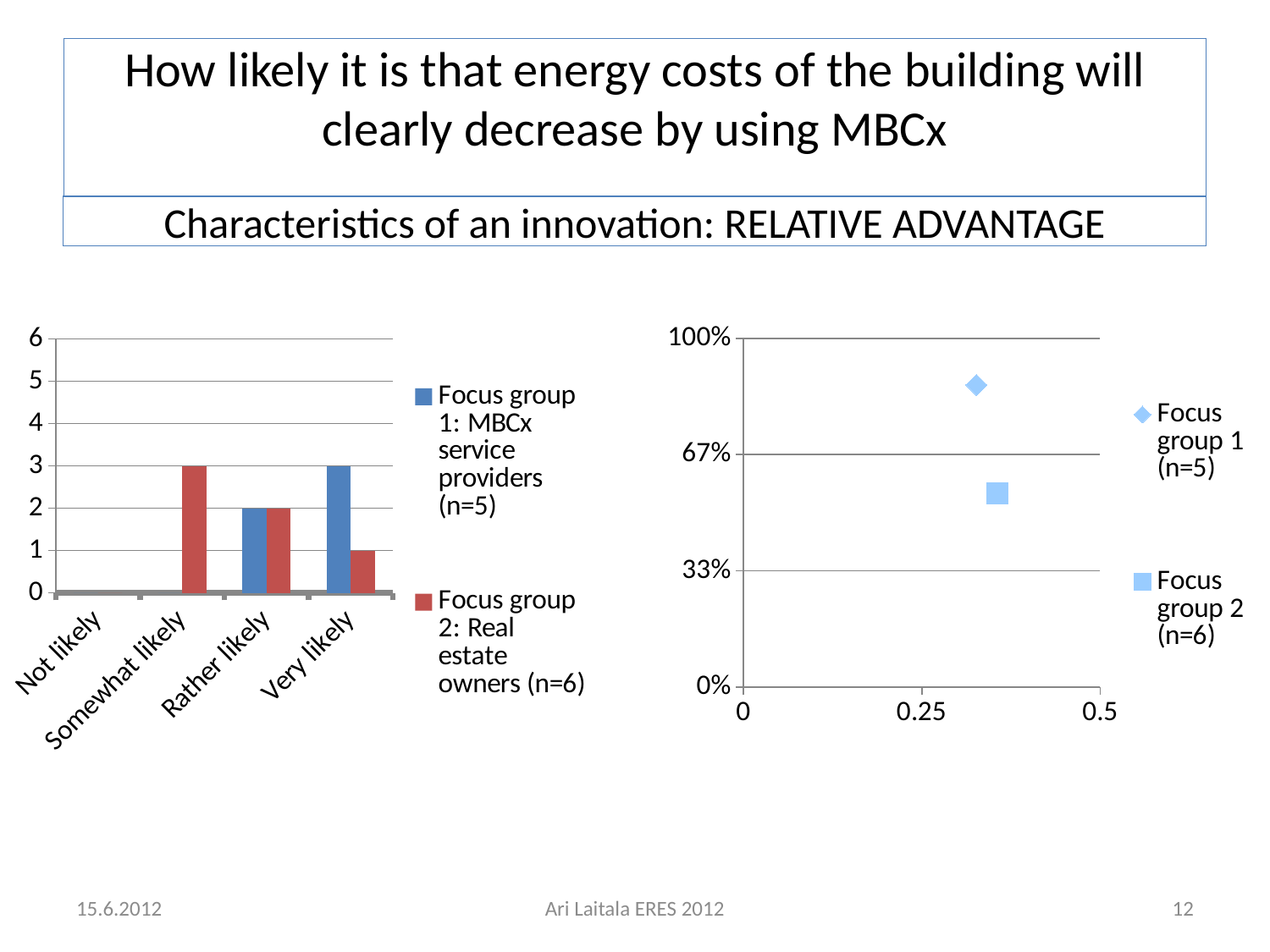
How many categories are shown on the x axis of the left bar chart? 4 In the left bar chart, what is the difference between Focus group 1 and Focus group 2 for Very likely? 2 In the left bar chart, which category has the highest value for Focus group 2: Real estate owners (n=6)? Somewhat likely In the left bar chart, which is larger for Very likely: Focus group 1 or Focus group 2? Focus group 1 In the right scatter chart, is the vertical value for Focus group 2 (n=6) greater or less than 67%? less In the left bar chart, what is the value for Focus group 1: MBCx service providers (n=5) for Very likely? 3 What kind of chart is the chart on the left of the slide? Bar chart In the left bar chart, what is the value for Focus group 1: MBCx service providers (n=5) for Rather likely? 2 In the left bar chart, what is the value for Focus group 2: Real estate owners (n=6) for Somewhat likely? 3 In the right scatter chart, is the vertical value for Focus group 1 (n=5) greater or less than 67%? greater How many series does the legend of the left chart list? 2 In the left bar chart, what is the value for Focus group 2: Real estate owners (n=6) for Very likely? 1